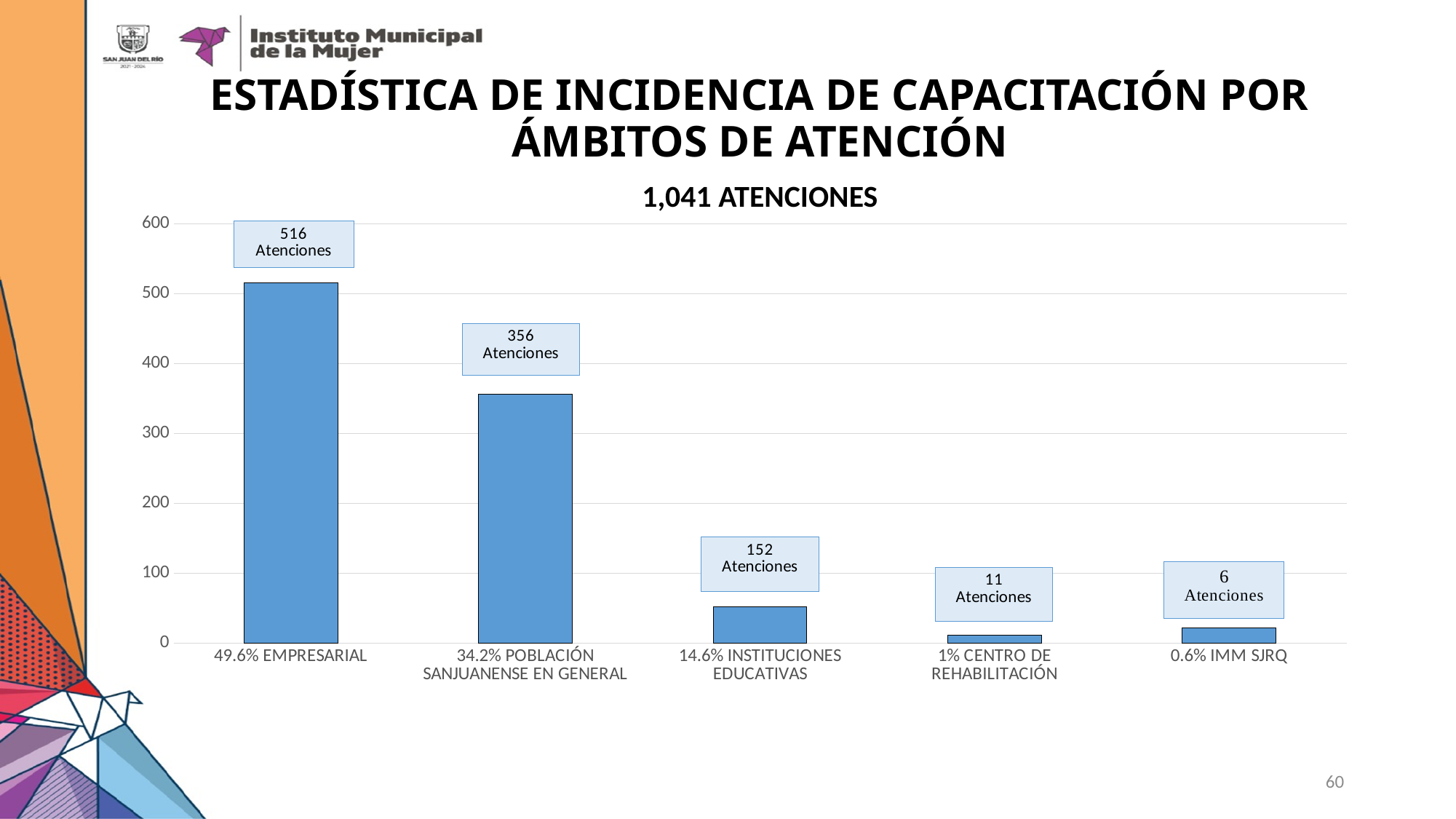
How many atenciones are labelled for INSTITUCIONES EDUCATIVAS? 152 Atenciones What is the title of the chart? 1,041 ATENCIONES How many atenciones are labelled for POBLACIÓN SANJUANENSE EN GENERAL? 356 Atenciones How many atenciones are labelled for CENTRO DE REHABILITACIÓN? 11 Atenciones What kind of chart is shown on the slide? bar chart Which category has the highest number of atenciones? 49.6% EMPRESARIAL How many atenciones are labelled for IMM SJRQ? 6 Atenciones Which has more atenciones, INSTITUCIONES EDUCATIVAS or CENTRO DE REHABILITACIÓN? INSTITUCIONES EDUCATIVAS How many categories are shown on the x axis of the chart? 5 What is the difference in atenciones between EMPRESARIAL and POBLACIÓN SANJUANENSE EN GENERAL? 160 How many atenciones are labelled for the EMPRESARIAL category? 516 Atenciones